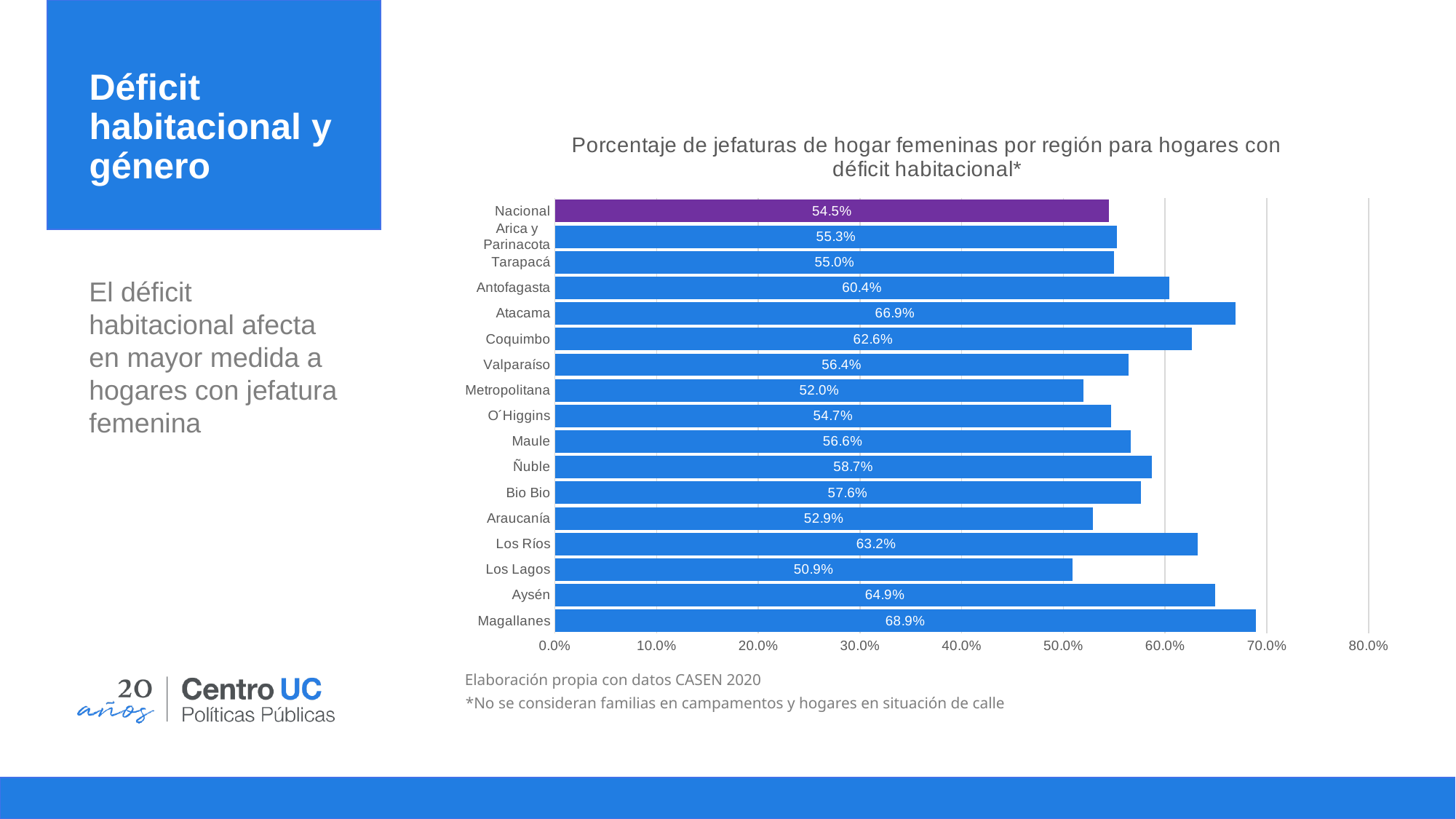
What kind of chart is shown on the slide? Bar chart How many bars are shown in the chart? 17 What is the difference between the values for Magallanes and Los Lagos? 18.0% What is the difference between the values for Atacama and Coquimbo? 4.3% What is the value for Magallanes? 68.9% Which is larger, the value for Los Ríos or the value for Aysén? Aysén What is the value for Metropolitana? 52.0% Which bar is shown in a different colour (purple) from the others? Nacional What is the value for Nacional? 54.5% Which region has the highest percentage? Magallanes Which region has the lowest percentage? Los Lagos Is the value for Antofagasta greater or less than 60.0%? greater